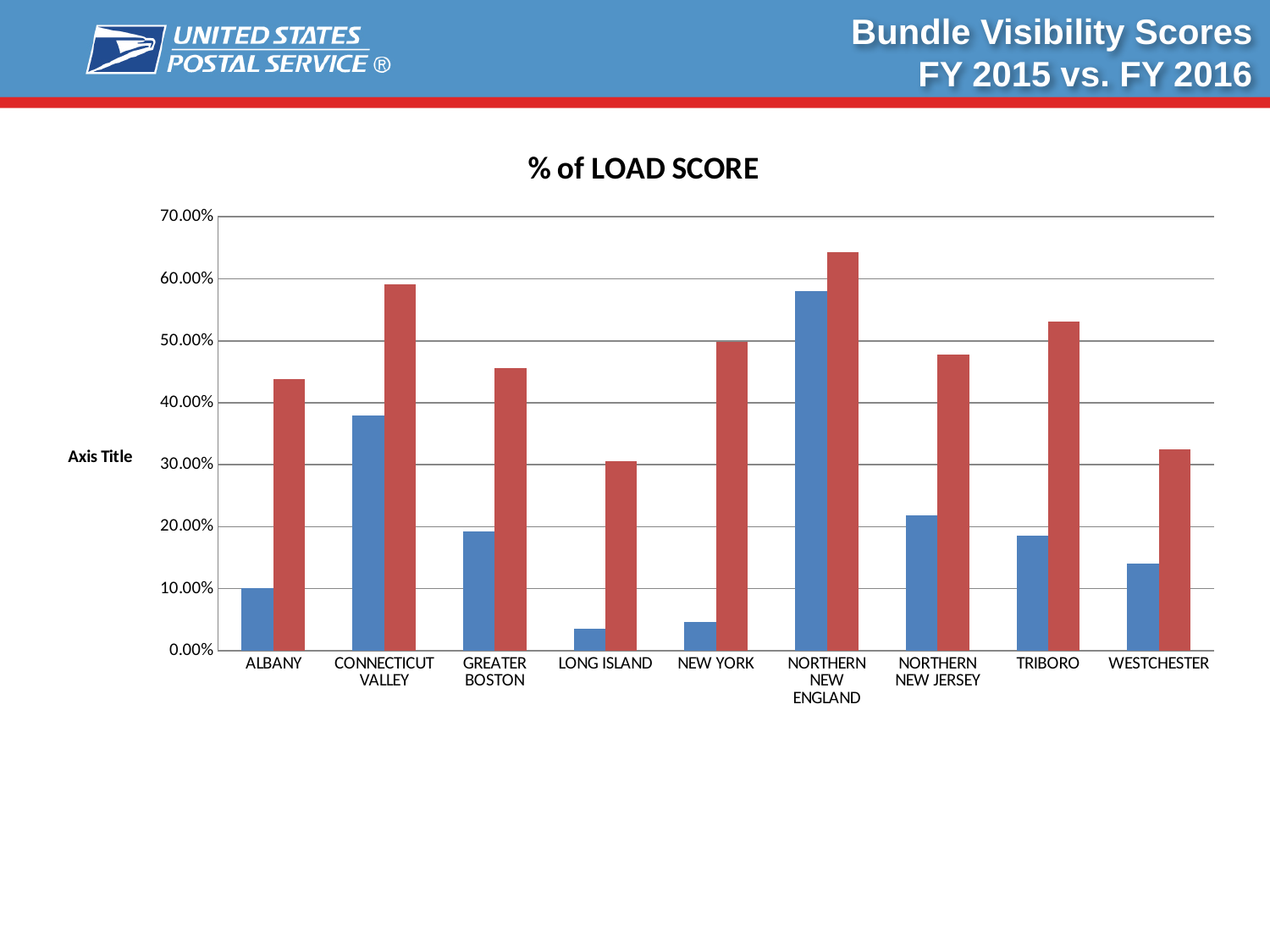
How many regions (categories) are shown on the x axis of the chart? 9 What kind of chart is shown on the slide? bar chart Which region has the shortest blue bar? LONG ISLAND What label is shown on the vertical axis of the chart? Axis Title Is the red bar for CONNECTICUT VALLEY greater or less than 50.00%? greater Which region has the tallest red bar? NORTHERN NEW ENGLAND Which region has the taller blue bar, CONNECTICUT VALLEY or GREATER BOSTON? CONNECTICUT VALLEY Is the red bar for LONG ISLAND greater or less than 40.00%? less Is the blue bar for ALBANY greater or less than 20.00%? less Which region has the tallest blue bar? NORTHERN NEW ENGLAND What is the title of the chart? % of LOAD SCORE Which region has the taller red bar, TRIBORO or WESTCHESTER? TRIBORO